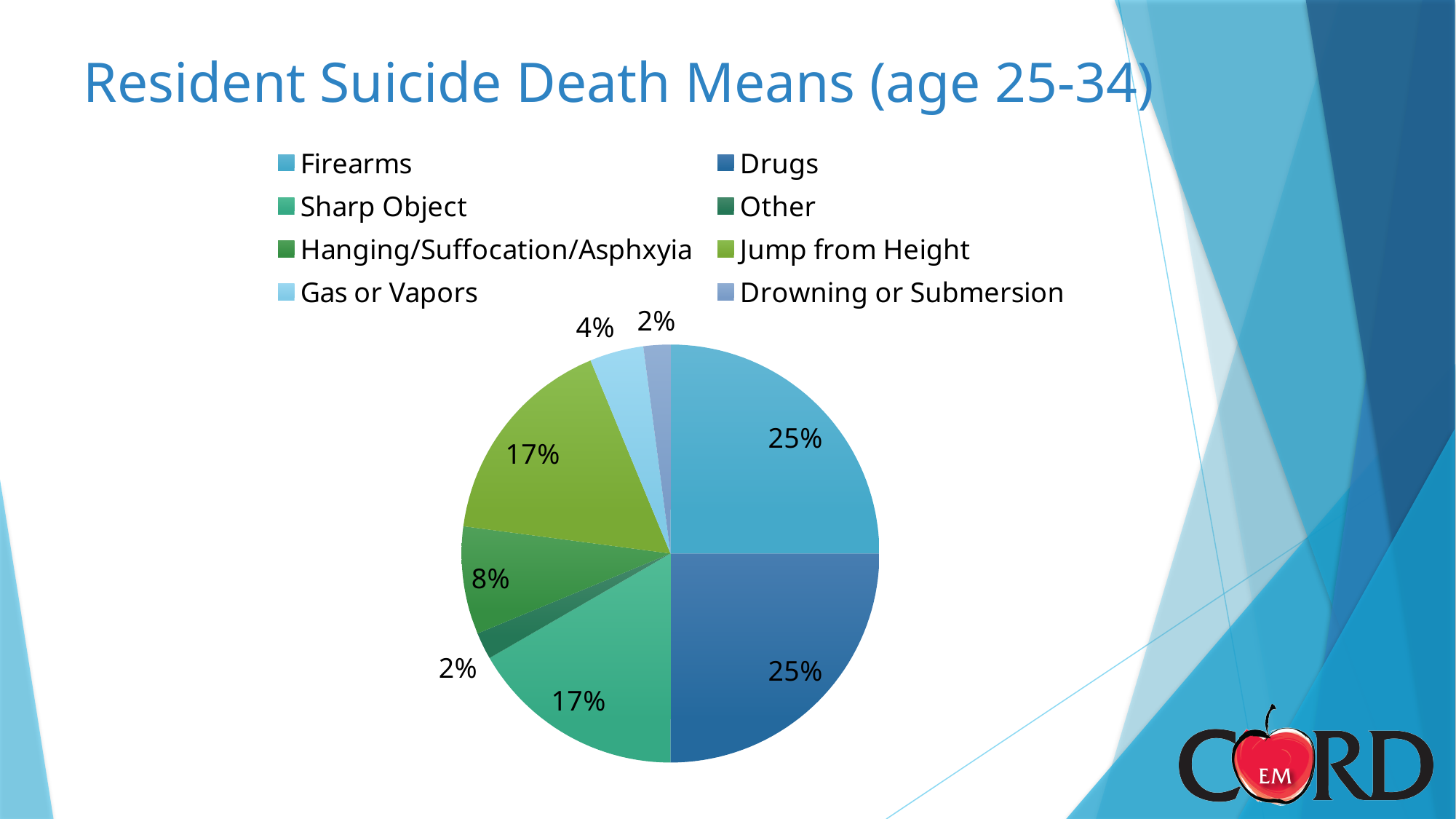
What share does Drowning or Submersion have? 2% What percentage is shown for Drugs? 25% Which two categories share the largest slice of the pie? Firearms and Drugs What percentage is shown for Gas or Vapors? 4% How many categories does the legend list? 8 What share does Jump from Height account for? 17% What share of the pie does Firearms account for? 25% What kind of chart is shown on the slide? Pie chart What percentage is shown for Hanging/Suffocation/Asphxyia? 8% What is the difference between the share for Jump from Height and the share for Hanging/Suffocation/Asphxyia? 9% Which is larger, the share for Gas or Vapors or the share for Hanging/Suffocation/Asphxyia? Hanging/Suffocation/Asphxyia What share does Sharp Object have? 17%